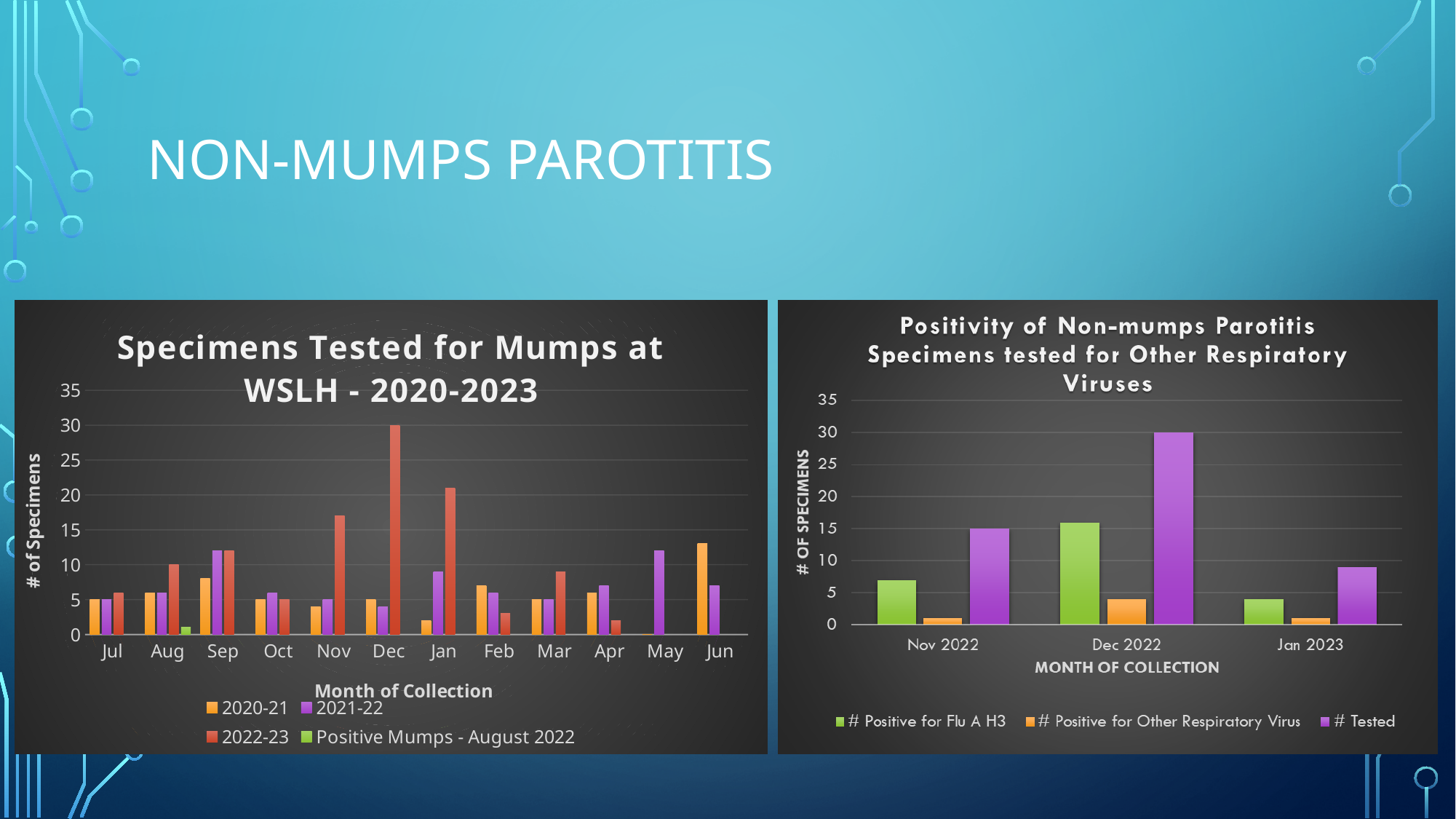
In the right chart, 'Positivity of Non-mumps Parotitis Specimens tested for Other Respiratory Viruses', which is larger for Nov 2022: '# Positive for Flu A H3' or '# Positive for Other Respiratory Virus'? # Positive for Flu A H3 In the left chart, 'Specimens Tested for Mumps at WSLH - 2020-2023', is the 2020-21 value for Jun greater or less than 10? greater In the left chart, 'Specimens Tested for Mumps at WSLH - 2020-2023', which is larger for Jan: the 2021-22 value or the 2022-23 value? 2022-23 In the left chart, 'Specimens Tested for Mumps at WSLH - 2020-2023', which month has the highest 2022-23 value? Dec How many months are shown on the x axis of the left chart, 'Specimens Tested for Mumps at WSLH - 2020-2023'? 12 In the right chart, 'Positivity of Non-mumps Parotitis Specimens tested for Other Respiratory Viruses', which month has the highest '# Tested' value? Dec 2022 What type of chart is the left chart, 'Specimens Tested for Mumps at WSLH - 2020-2023'? bar chart How many series does the legend of the left chart, 'Specimens Tested for Mumps at WSLH - 2020-2023', list? 4 In the left chart, 'Specimens Tested for Mumps at WSLH - 2020-2023', in which month does the 'Positive Mumps - August 2022' series appear? Aug How many series does the legend of the right chart, 'Positivity of Non-mumps Parotitis Specimens tested for Other Respiratory Viruses', list? 3 In the left chart, 'Specimens Tested for Mumps at WSLH - 2020-2023', is the 2022-23 value for Nov greater or less than 15? greater In the right chart, 'Positivity of Non-mumps Parotitis Specimens tested for Other Respiratory Viruses', is the '# Positive for Flu A H3' value for Dec 2022 greater or less than 10? greater